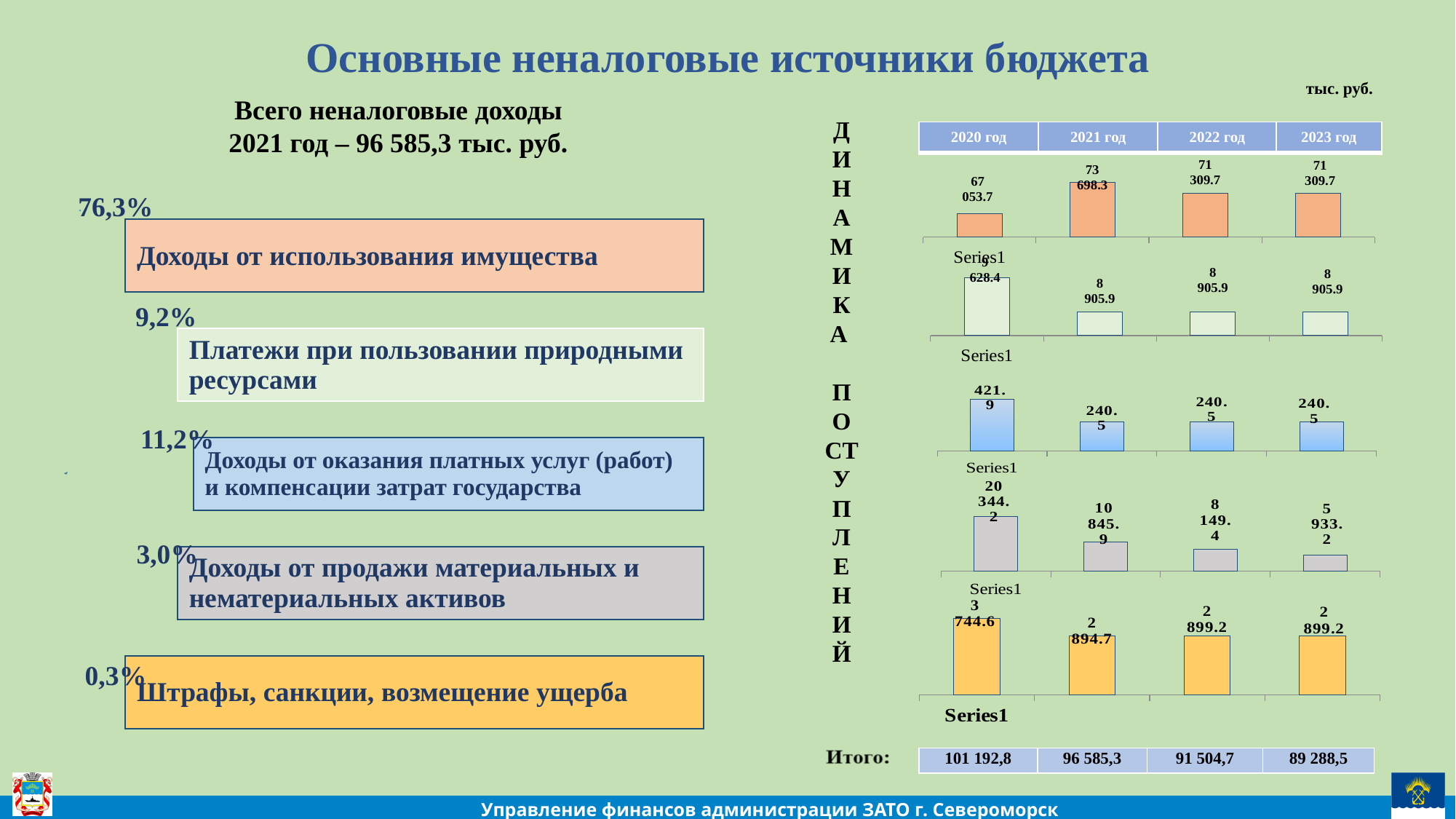
In the top (orange) bar chart on the right, which year has the lowest value? 2020 год In the bottom (yellow) bar chart on the right, what is the value for 2020 год? 3 744.6 In the third (blue) bar chart on the right, what is the value for 2020 год? 421.9 In the fourth (grey) bar chart on the right, do the values rise or fall from 2020 год to 2023 год? fall In the third (blue) bar chart on the right, which year has the highest value? 2020 год What type of chart is used on the right side of the slide to show the dynamics of receipts? bar chart In the fourth (grey) bar chart on the right, what is the difference between the 2020 год and 2021 год values? 9 498.3 In the bottom (yellow) bar chart on the right, which is larger: the value for 2020 год or the value for 2021 год? 2020 год How many bars does each of the bar charts on the right side of the slide have? 4 In the fourth (grey) bar chart on the right, what is the value for 2023 год? 5 933.2 In the top (orange) bar chart on the right, what is the value for 2021 год? 73 698.3 In the top (orange) bar chart on the right, what is the difference between the 2021 год and 2020 год values? 6 644.6